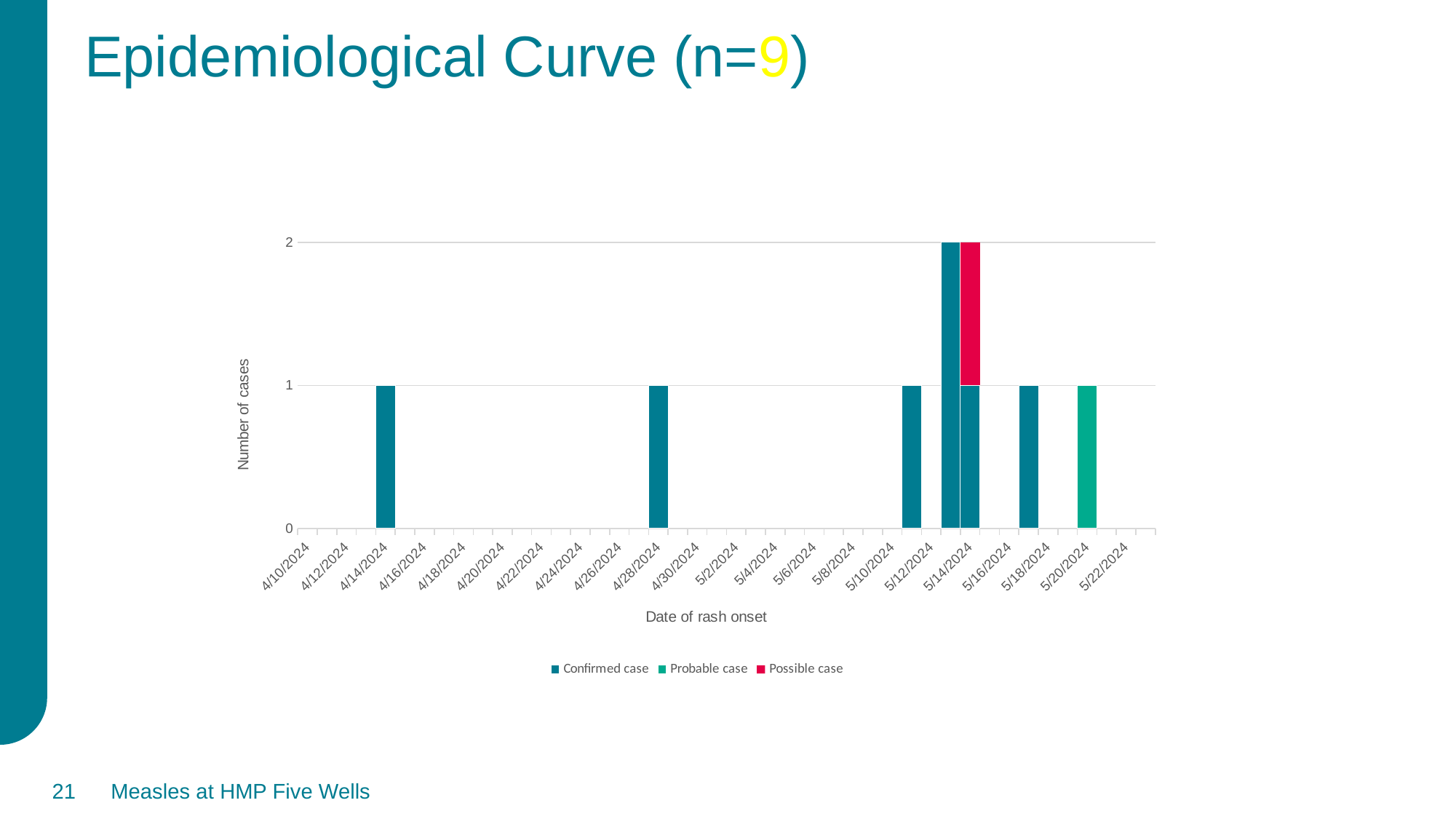
What kind of chart is shown on the slide? Bar chart What is the total number of cases in the stacked bar for 5/14/2024? 2 How many series does the legend list? 3 How many confirmed cases are plotted for 4/28/2024? 1 How many confirmed cases are plotted for 4/14/2024? 1 Which date has more total cases, 4/28/2024 or 5/14/2024? 5/14/2024 On how many dates is a possible case plotted? 1 How many probable cases are plotted for 5/20/2024? 1 What are the three series named in the legend? Confirmed case, Probable case, Possible case What is the x-axis title of the chart? Date of rash onset What is the highest number of cases reached by any single bar in the chart? 2 How many possible cases are plotted for 5/14/2024? 1